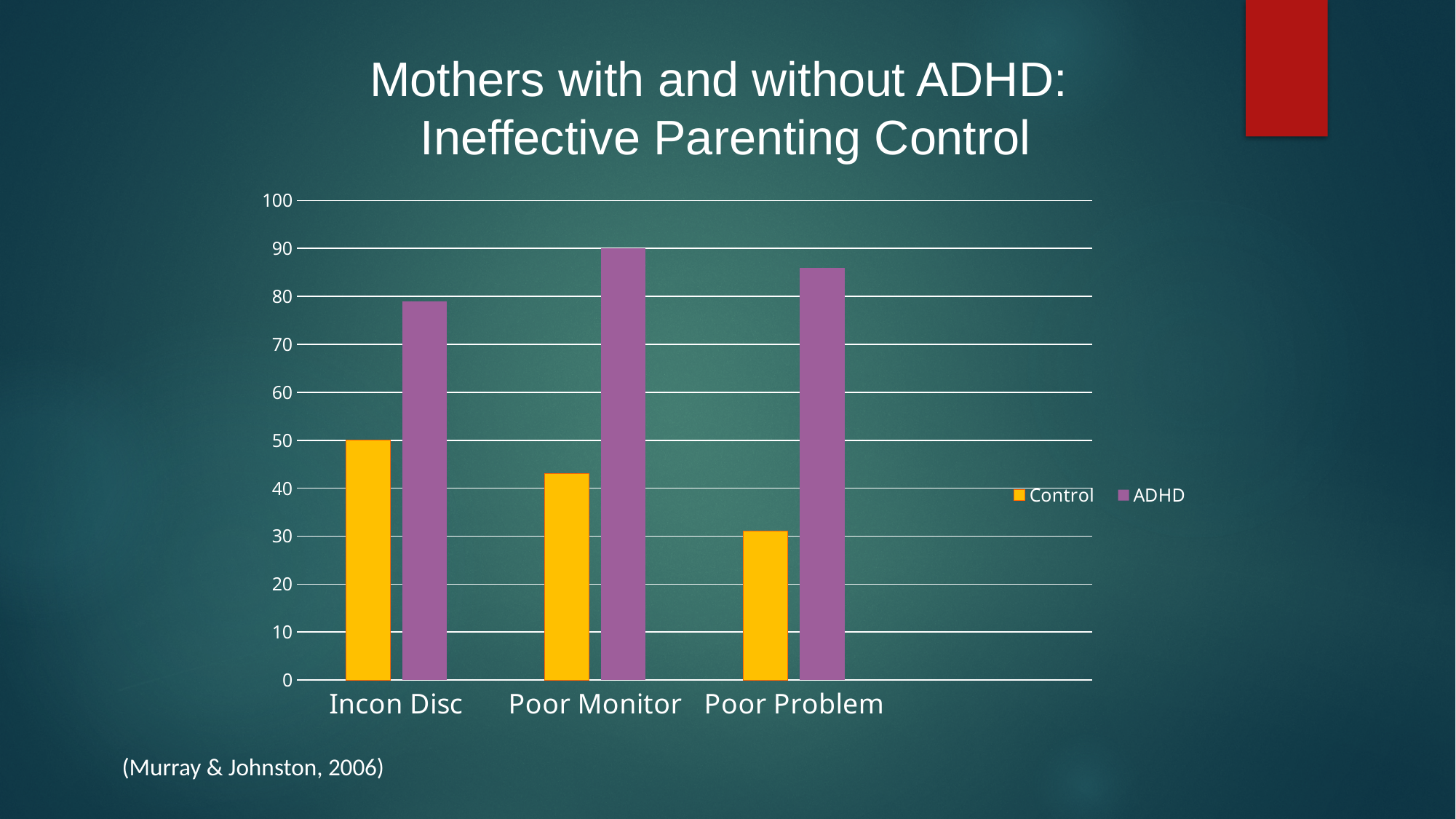
What kind of chart is shown on the slide? bar chart Which category has the highest ADHD value? Poor Monitor In the Poor Problem category, which series has the larger value, Control or ADHD? ADHD How many categories are shown on the x axis? 3 Which category has the lowest Control value? Poor Problem Is the value for Control in the Poor Monitor category greater or less than 50? less Is the value for Control in the Poor Problem category greater or less than 40? less Is the value for ADHD in the Incon Disc category greater or less than 70? greater What colour are the ADHD bars? purple What is the value for ADHD in the Poor Monitor category? 90 What is the value for Control in the Incon Disc category? 50 How many series does the legend list? 2